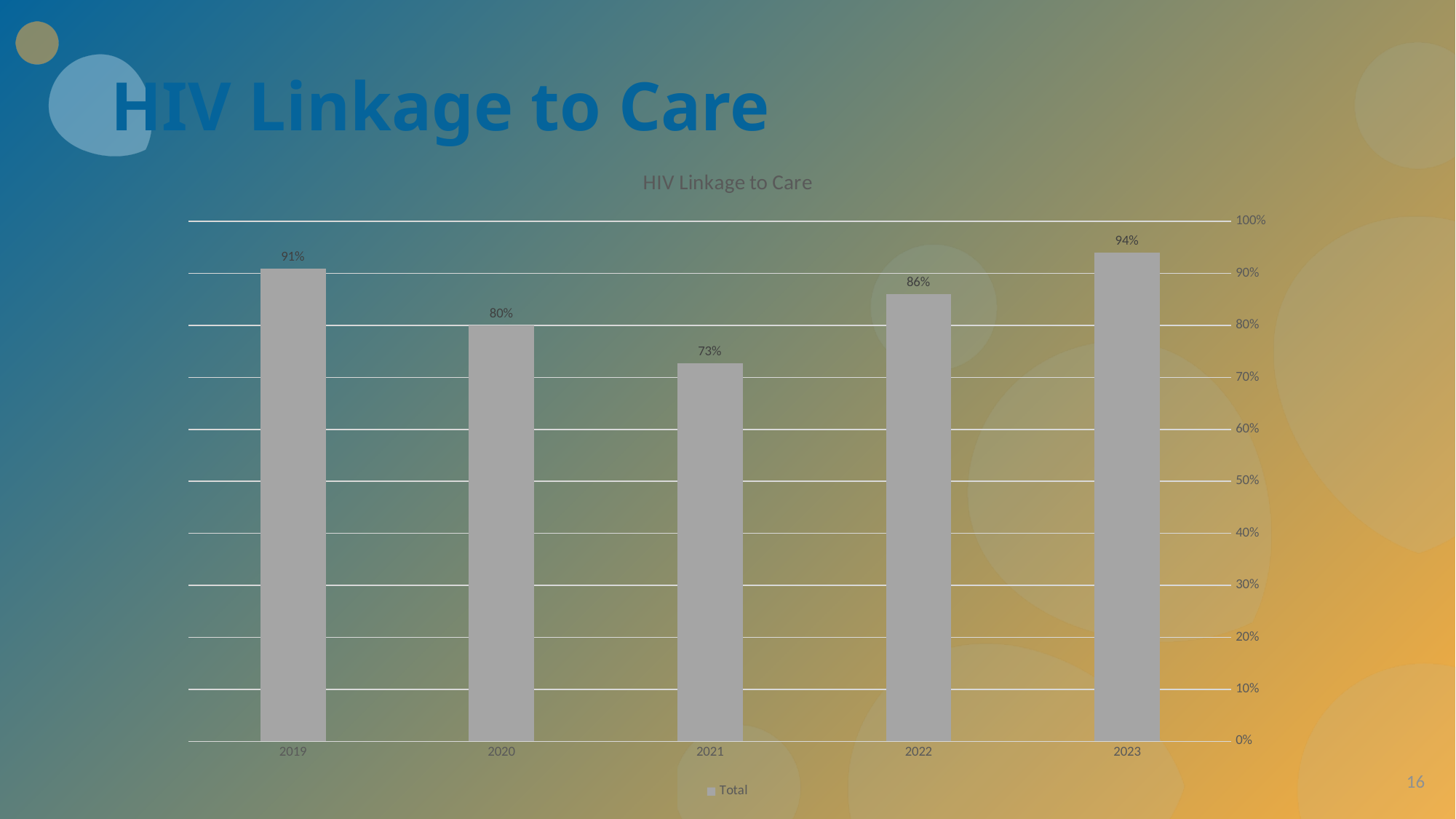
What is the difference between the 2019 and 2020 values? 11% What is the HIV linkage to care value for 2019? 91% Which year has the highest HIV linkage to care value? 2023 Which year has the lowest HIV linkage to care value? 2021 How many years are shown on the x axis? 5 Is the value for 2022 greater or less than 80%? greater What is the HIV linkage to care value for 2021? 73% What is the name of the series listed in the legend? Total What is the difference between the 2023 and 2021 values? 21% Which is larger, the value for 2020 or the value for 2022? 2022 What kind of chart is shown on the slide? Bar chart What is the HIV linkage to care value for 2023? 94%